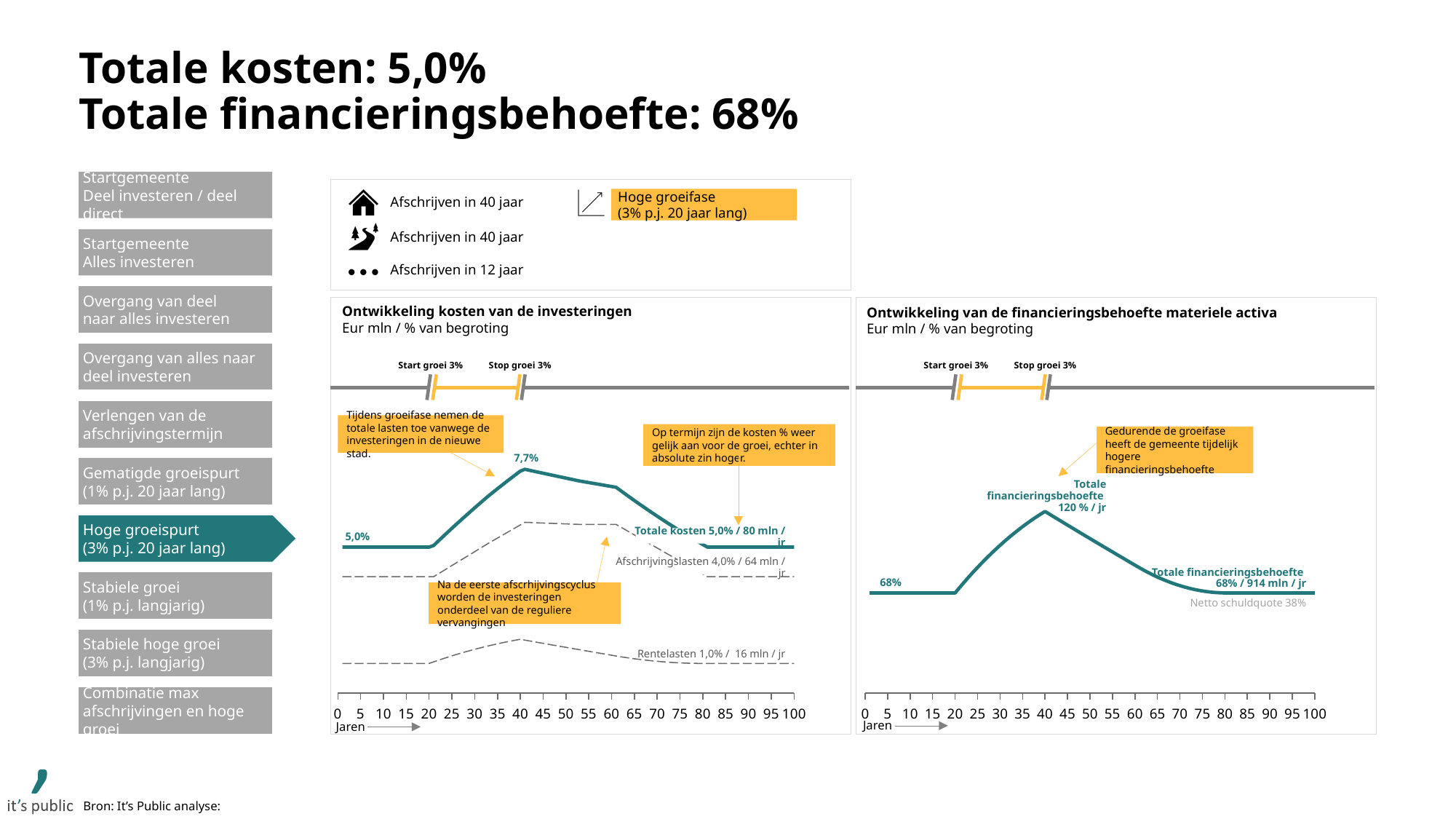
In the chart 'Ontwikkeling kosten van de investeringen', what is the peak value labelled on the Totale kosten line? 7,7% In the chart 'Ontwikkeling kosten van de investeringen', what is the difference between the peak Totale kosten value of 7,7% and the starting value of 5,0%? 2,7% In the chart 'Ontwikkeling van de financieringsbehoefte materiele activa', what is the final value labelled for Totale financieringsbehoefte? 68% / 914 mln / jr In the chart 'Ontwikkeling kosten van de investeringen', what is the final value labelled for Totale kosten? 5,0% / 80 mln / jr In the chart 'Ontwikkeling kosten van de investeringen', what is the starting value of the Totale kosten line at year 0? 5,0% In the chart 'Ontwikkeling van de financieringsbehoefte materiele activa', what is the peak value labelled for Totale financieringsbehoefte? 120 % / jr In the chart 'Ontwikkeling van de financieringsbehoefte materiele activa', what value is given for Netto schuldquote? 38% In the chart 'Ontwikkeling van de financieringsbehoefte materiele activa', does the Totale financieringsbehoefte line rise or fall between year 20 and year 40? rise In the chart 'Ontwikkeling kosten van de investeringen', what value is labelled for Afschrijvingslasten? 4,0% / 64 mln / jr In the chart 'Ontwikkeling kosten van de investeringen', which line is higher: Afschrijvingslasten or Rentelasten? Afschrijvingslasten What type of chart is 'Ontwikkeling kosten van de investeringen'? line chart In the chart 'Ontwikkeling kosten van de investeringen', what value is labelled for Rentelasten? 1,0% / 16 mln / jr